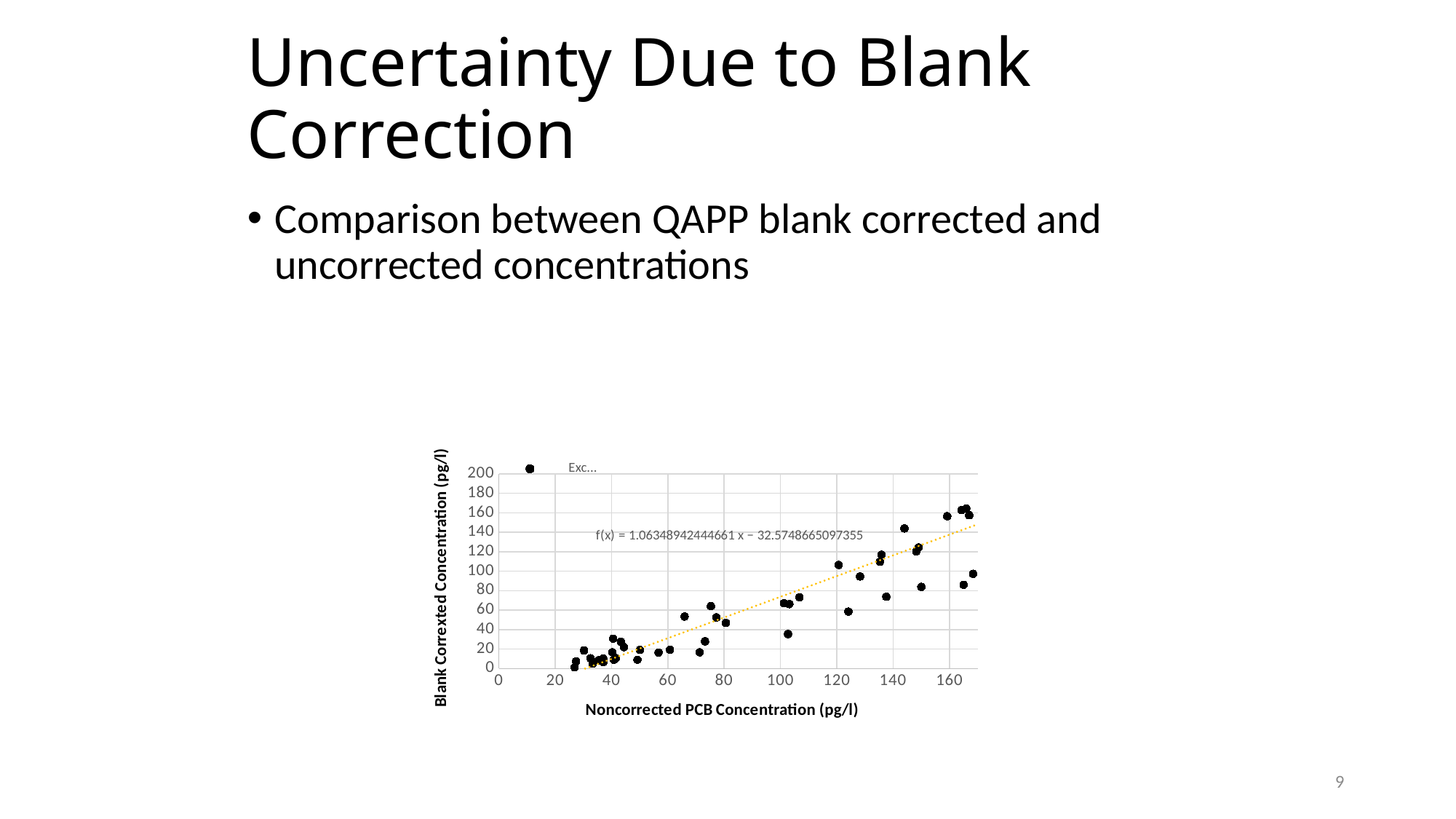
What is the intercept of the fitted line shown in the trendline equation? −32.5748665097355 Is the highest plotted blank corrected concentration greater or less than 140? greater What is the slope of the fitted line shown in the trendline equation? 1.06348942444661 What kind of chart is shown on the slide? scatter chart Do the blank corrected concentrations generally rise or fall as the noncorrected concentration increases along the x axis? rise Is the lowest plotted blank corrected concentration greater or less than 20? less What is the title of the x axis of the chart? Noncorrected PCB Concentration (pg/l) Is the slope of the fitted trendline greater or less than 1? greater What equation is printed for the fitted trendline on the chart? f(x) = 1.06348942444661 x − 32.5748665097355